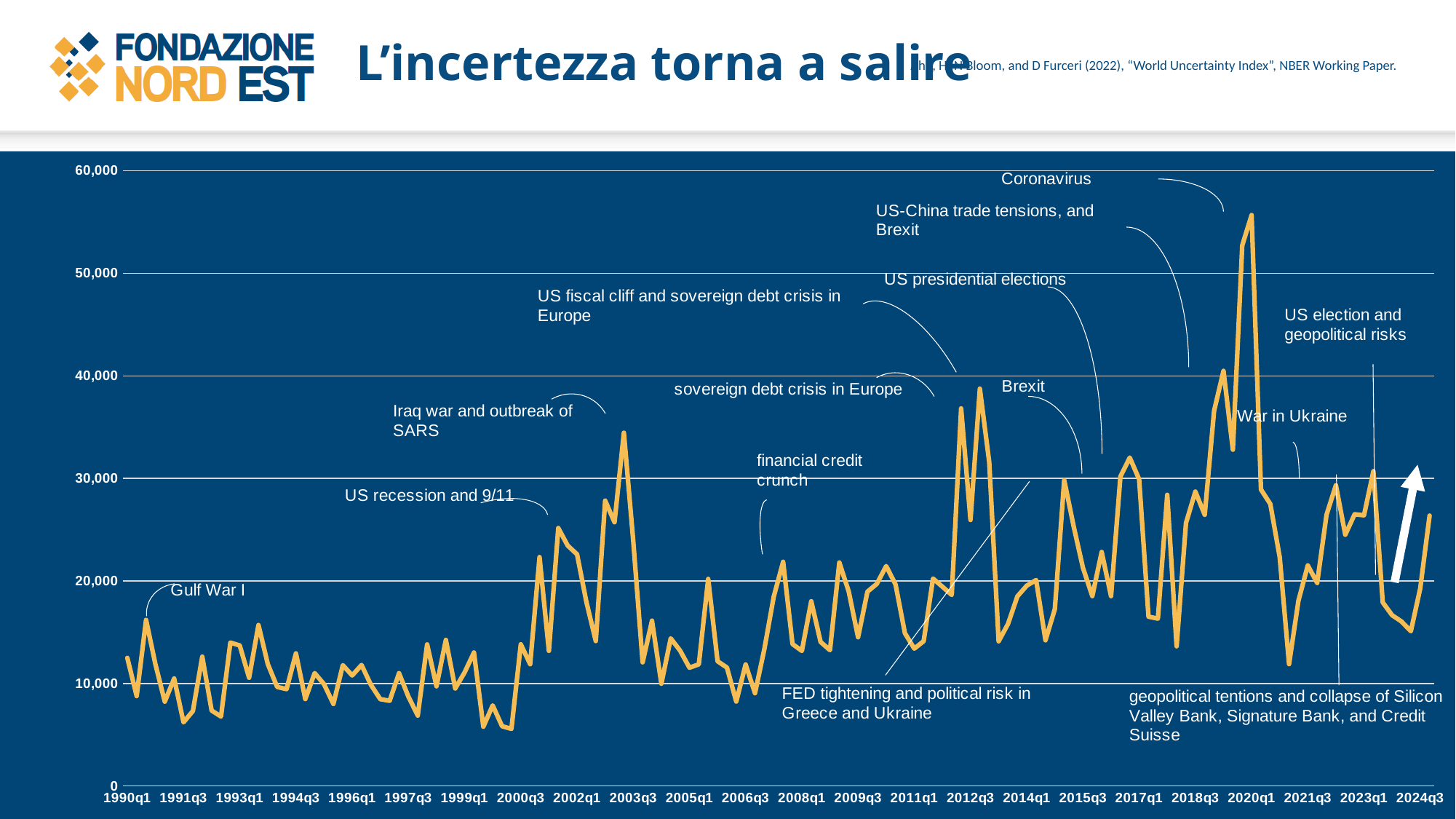
How many lines (series) are plotted on the chart? 1 Which peak is higher: the Coronavirus peak or the 'Iraq war and outbreak of SARS' peak? Coronavirus Overall, does the line rise or fall from 1990q1 to 2024q3? rise Which peak is higher: the Gulf War I peak or the Brexit peak? Brexit What kind of chart is shown on the slide? line chart What is the title of the slide containing the chart? L'incertezza torna a salire Is the value at the 'Iraq war and outbreak of SARS' peak greater or less than 30,000? greater Is the value at the Coronavirus peak greater or less than 50,000? greater Is the lowest value of the line, around 2000, greater or less than 10,000? less Which annotated event corresponds to the highest peak of the line? Coronavirus